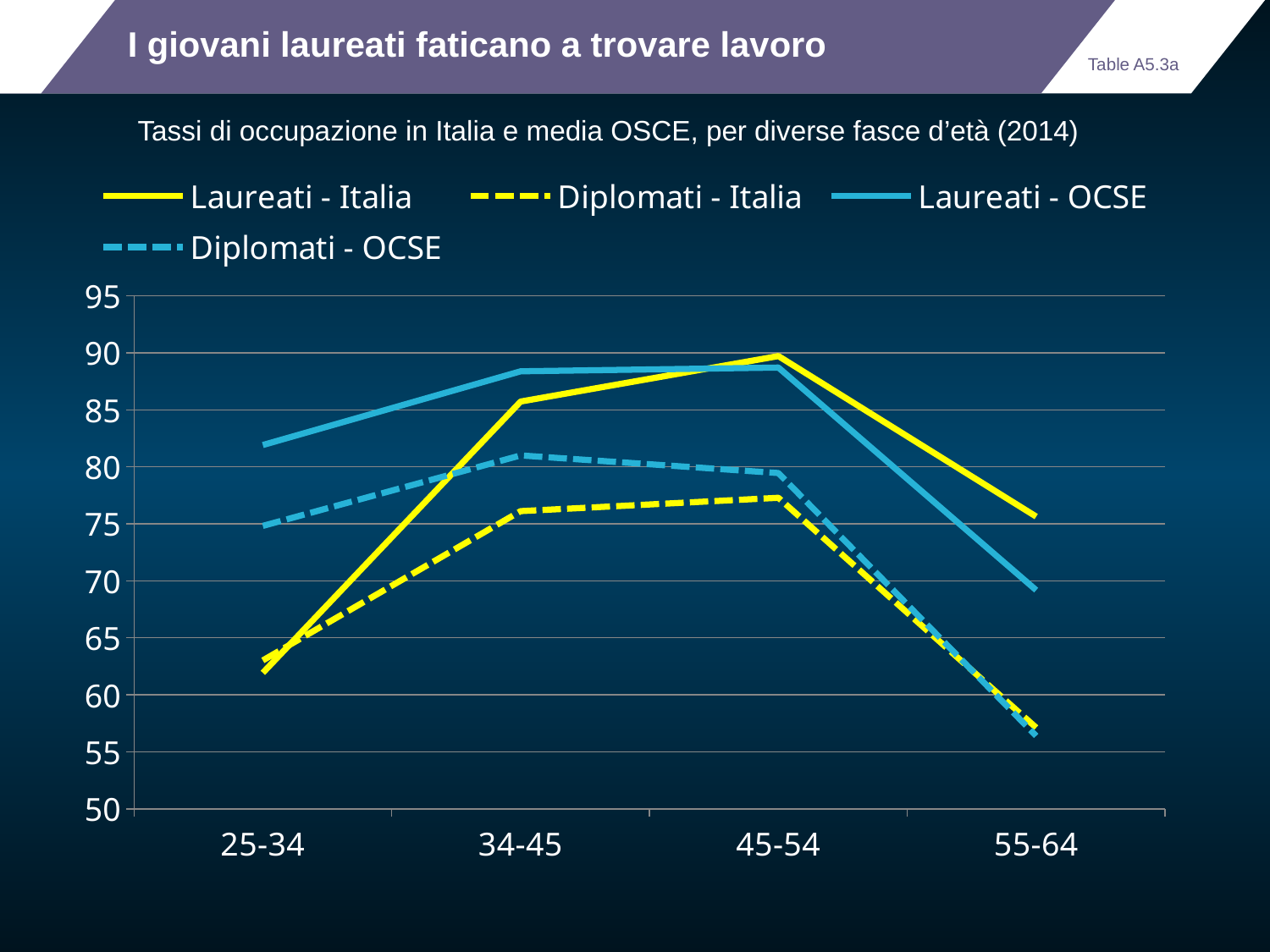
Does the Laureati - OCSE series rise or fall from the 45-54 age group to the 55-64 age group? fall For the Diplomati - OCSE series, which age group has the lowest value? 55-64 Is the value for Diplomati - Italia in the 55-64 age group greater or less than 60? less Is the value for Laureati - Italia in the 45-54 age group greater or less than 85? greater Is the value for Laureati - Italia in the 25-34 age group greater or less than 65? less For the Laureati - Italia series, which age group has the highest value? 45-54 What kind of chart is shown on the slide? line chart In the 55-64 age group, which is larger: Laureati - Italia or Laureati - OCSE? Laureati - Italia How many series does the legend list? 4 How many age groups are shown on the x axis? 4 In the 25-34 age group, which is larger: Laureati - Italia or Laureati - OCSE? Laureati - OCSE